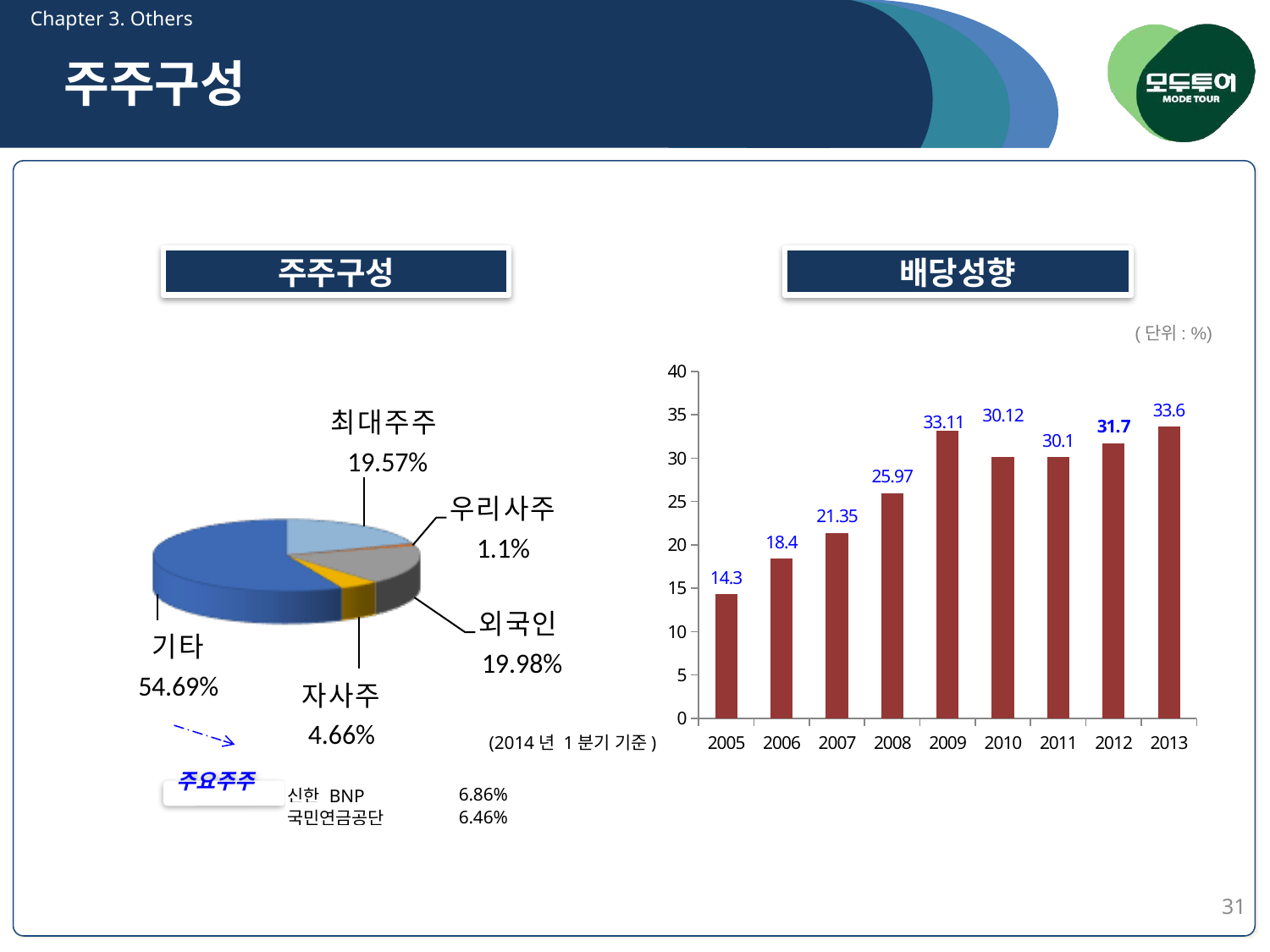
In the 배당성향 bar chart, how many years are shown on the x axis? 9 What kind of chart is the 배당성향 chart? bar chart In the 배당성향 bar chart, what is the value for 2009? 33.11 In the 배당성향 bar chart, what is the value for 2005? 14.3 In the 배당성향 bar chart, which year has the highest value? 2013 In the 배당성향 bar chart, which year has the lowest value? 2005 In the 주주구성 pie chart, which is larger, 최대주주 or 자사주? 최대주주 In the 배당성향 bar chart, what is the difference between the values for 2013 and 2005? 19.3 In the 주주구성 pie chart, what is the value for 우리사주? 1.1% In the 배당성향 bar chart, do the values generally rise or fall from 2005 to 2009? rise In the 주주구성 pie chart, what share does 기타 hold? 54.69% In the 배당성향 bar chart, which is larger, the value for 2008 or the value for 2012? 2012